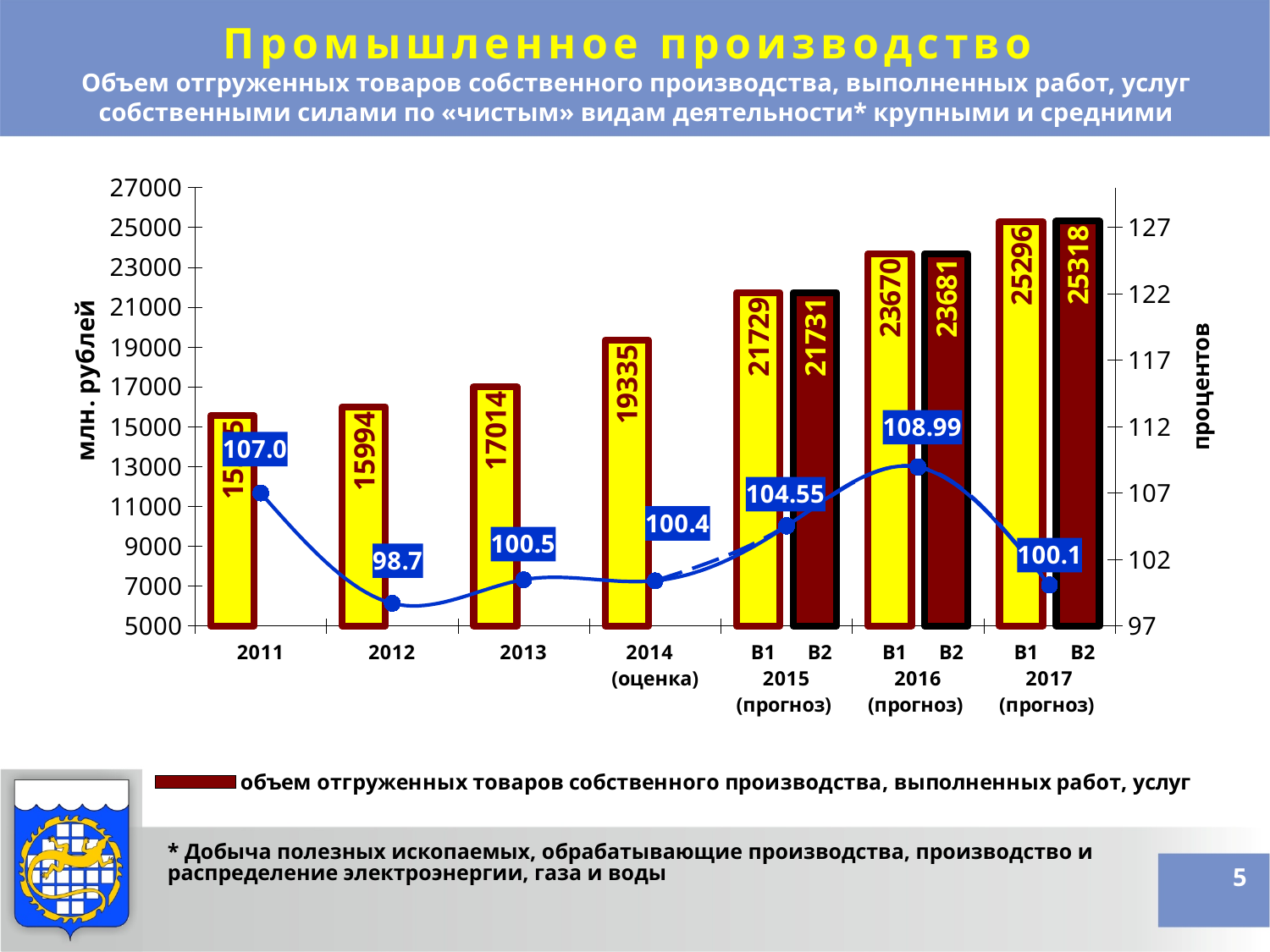
What is the value of the В2 bar for 2016 (прогноз)? 23681 What is the value of the В1 bar for 2017 (прогноз)? 25296 Do the bar values rise or fall from 2011 to 2017? rise Which year has the highest value on the percentage line? 2016 (прогноз) What is the label of the left vertical axis? млн. рублей What percentage value does the line show for 2016 (прогноз)? 108.99 What percentage value does the line show for 2012? 98.7 What is the difference between the bar values for 2014 (оценка) and 2013? 2321 Which year has the lowest value on the percentage line? 2012 What is the value of the bar for 2014 (оценка)? 19335 What is the difference between the В2 and В1 bar values for 2017 (прогноз)? 22 What is the value of the bar for 2013? 17014